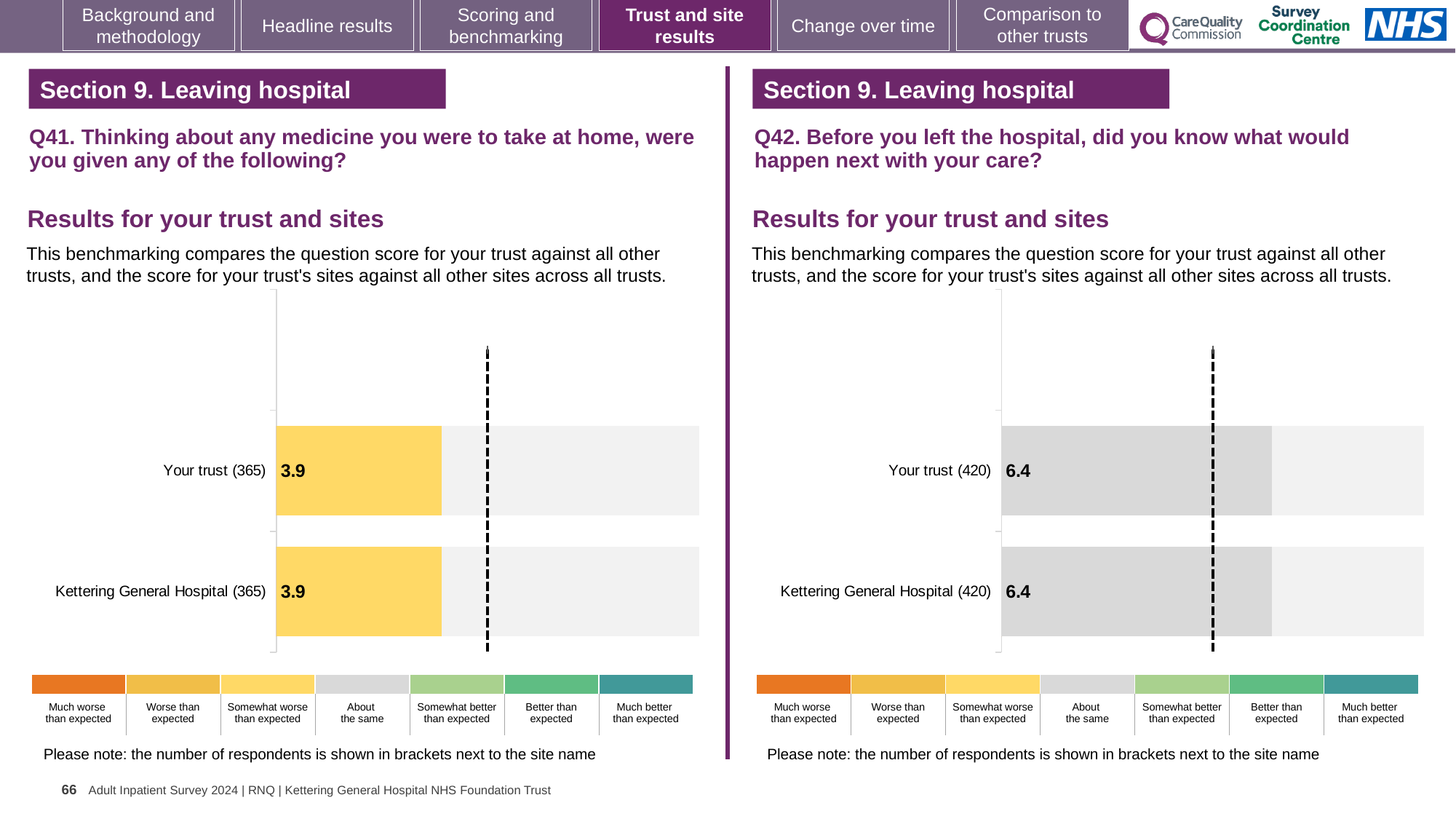
What kind of chart is used for the Q41 results on the left? Bar chart How many categories does the colour key below the Q42 chart on the right list? 7 In the Q41 chart on the left, what is the difference between the score for Your trust and the score for Kettering General Hospital? 0 In the Q42 chart on the right, what is the score for Kettering General Hospital? 6.4 In the Q42 chart on the right, what is the score for Your trust? 6.4 In the Q41 chart on the left, how many respondents are shown in brackets for Your trust? 365 Which chart has the higher score for Your trust, the Q41 chart on the left or the Q42 chart on the right? The Q42 chart on the right How many bars are plotted in the Q42 chart on the right? 2 In the Q41 chart on the left, what is the score for Your trust? 3.9 In the Q42 chart on the right, how many respondents are shown in brackets for Kettering General Hospital? 420 In the Q41 chart on the left, what is the score for Kettering General Hospital? 3.9